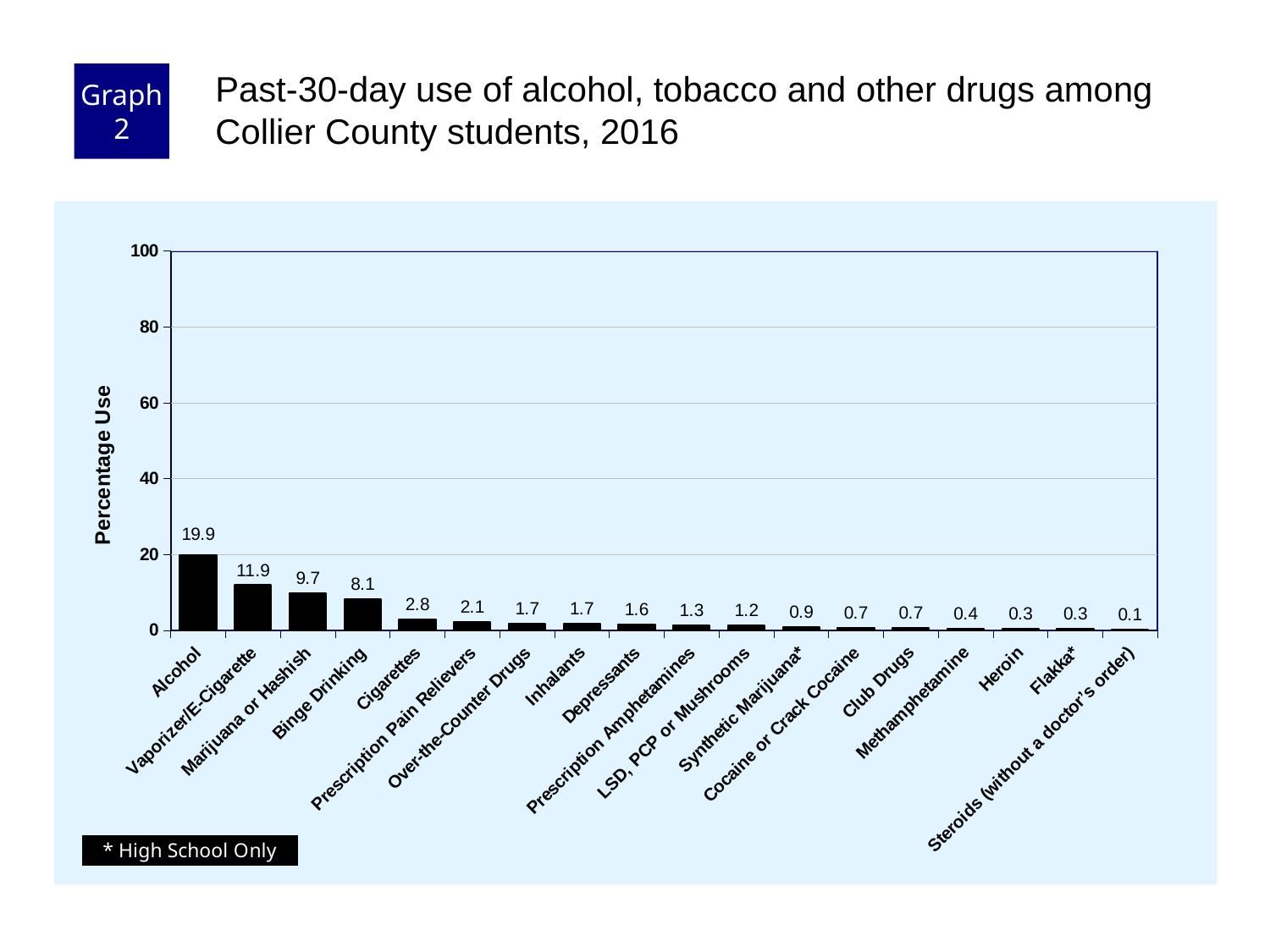
Which category has the highest percentage use? Alcohol What is the difference between the values for Alcohol and Vaporizer/E-Cigarette? 8.0 Is the value for Alcohol greater or less than 20? less What is the percentage use value for Alcohol? 19.9 How many categories are shown on the x axis? 18 What kind of chart is shown on the slide? bar chart What is the percentage use value for Binge Drinking? 8.1 What is the percentage use value for Methamphetamine? 0.4 Which category has the lowest percentage use? Steroids (without a doctor's order) What is the label of the y axis? Percentage Use What is the percentage use value for Cigarettes? 2.8 Which is larger, the value for Marijuana or Hashish or the value for Binge Drinking? Marijuana or Hashish